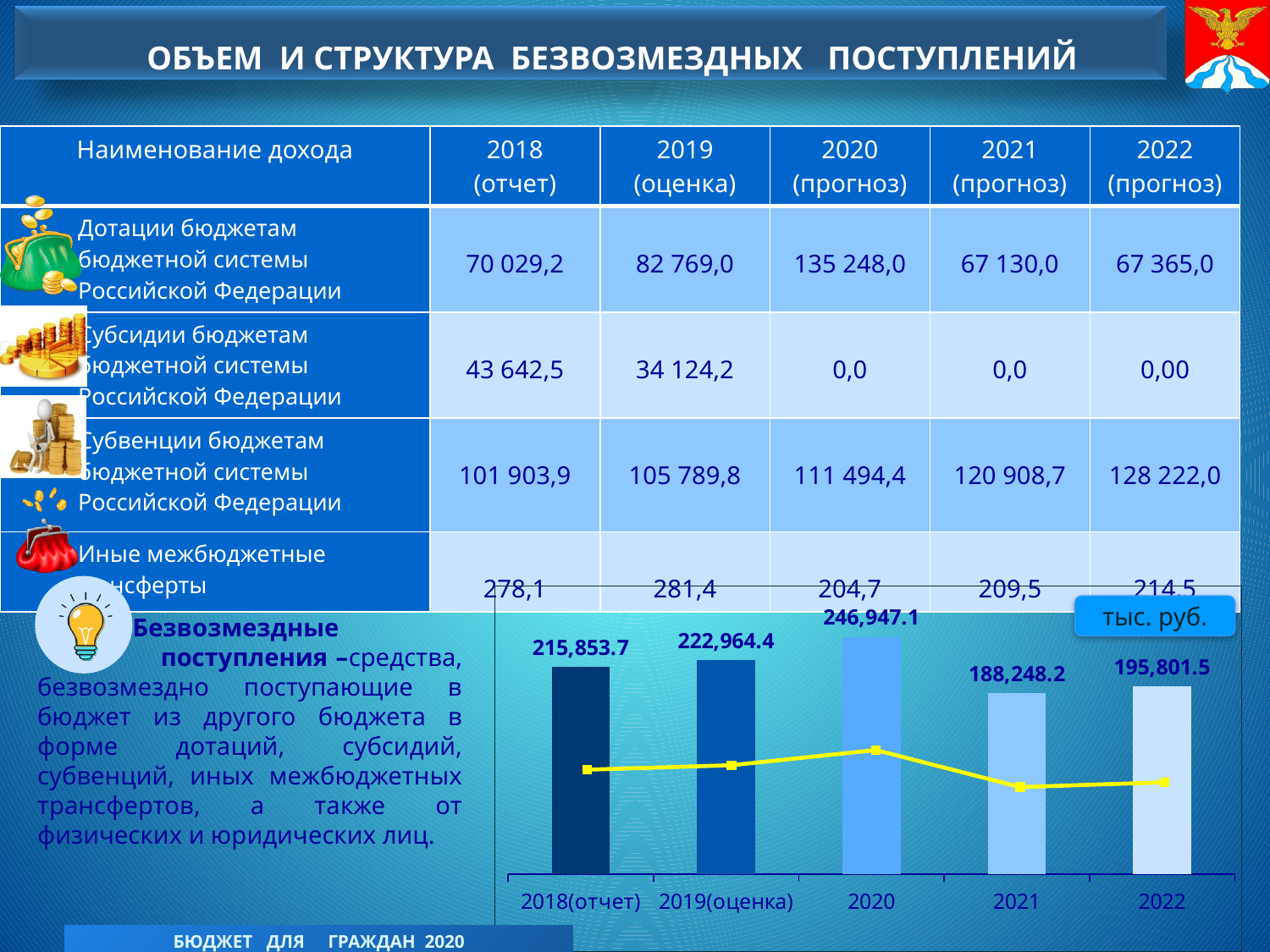
What is the value of the bar for 2019(оценка) in the chart? 222,964.4 What is the difference between the bar values for 2020 and 2018(отчет)? 31,093.4 What is the value of the bar for 2021 in the chart? 188,248.2 What is the difference between the bar values for 2022 and 2021? 7,553.3 What unit is indicated for the chart values? тыс. руб. What is the value of the bar for 2022 in the chart? 195,801.5 Which year has the highest bar in the chart? 2020 How many categories are shown on the x axis of the chart? 5 What is the value of the bar for 2018(отчет) in the chart? 215,853.7 Which bar is larger, 2019(оценка) or 2021? 2019(оценка) Which year has the lowest bar in the chart? 2021 What is the value of the bar for 2020 in the chart? 246,947.1